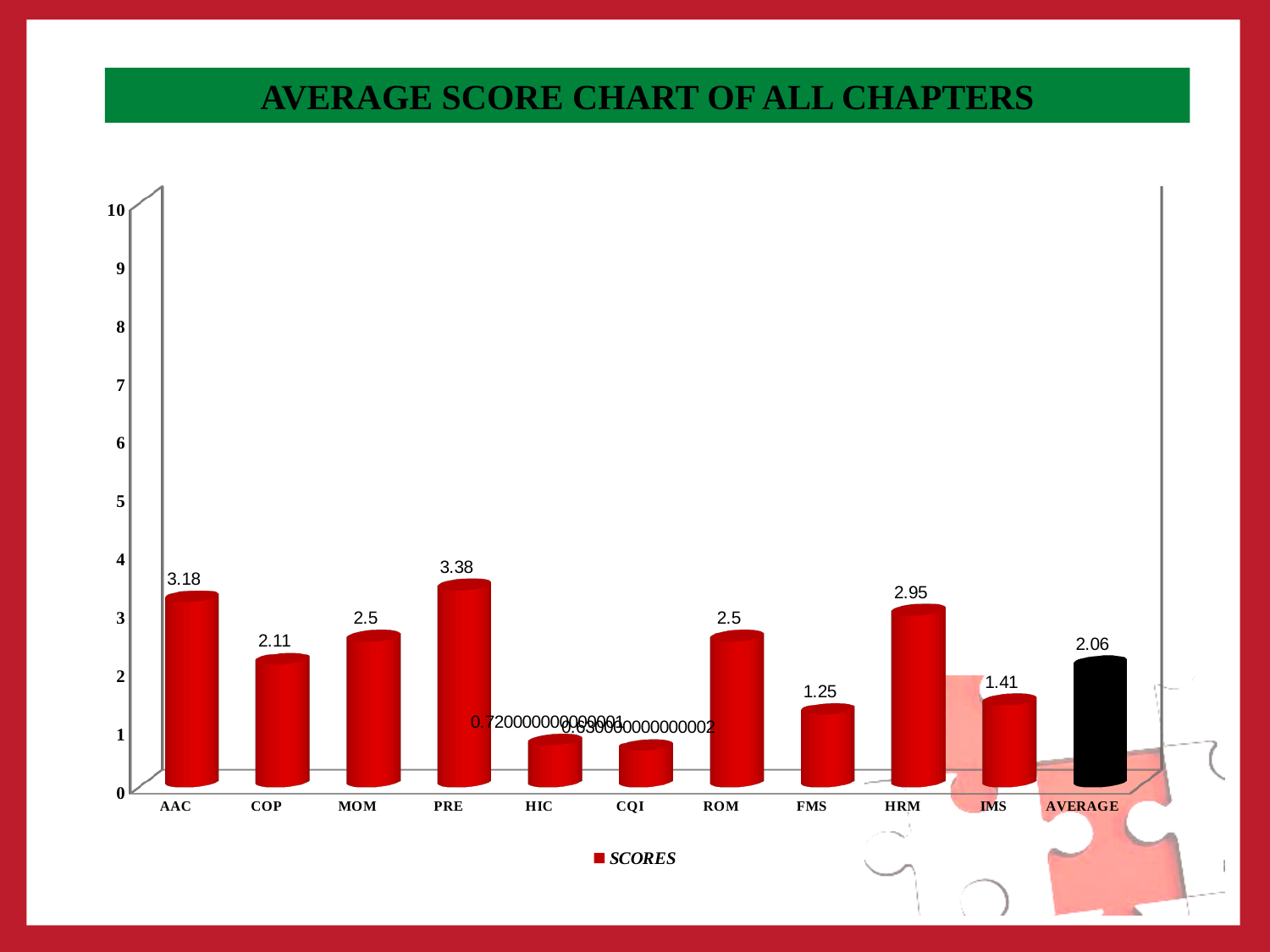
What kind of chart is shown on the slide? Bar chart Is the value for FMS greater or less than 2? less What is the title of the chart? AVERAGE SCORE CHART OF ALL CHAPTERS What is the score for HRM? 2.95 What is the score for AAC? 3.18 What is the score for PRE? 3.38 How many series does the legend list? 1 Which has a higher score, COP or MOM? MOM What is the difference between the scores for PRE and AAC? 0.2 Which chapter has the highest score? PRE What is the value shown for AVERAGE? 2.06 How many categories are shown on the x axis? 11